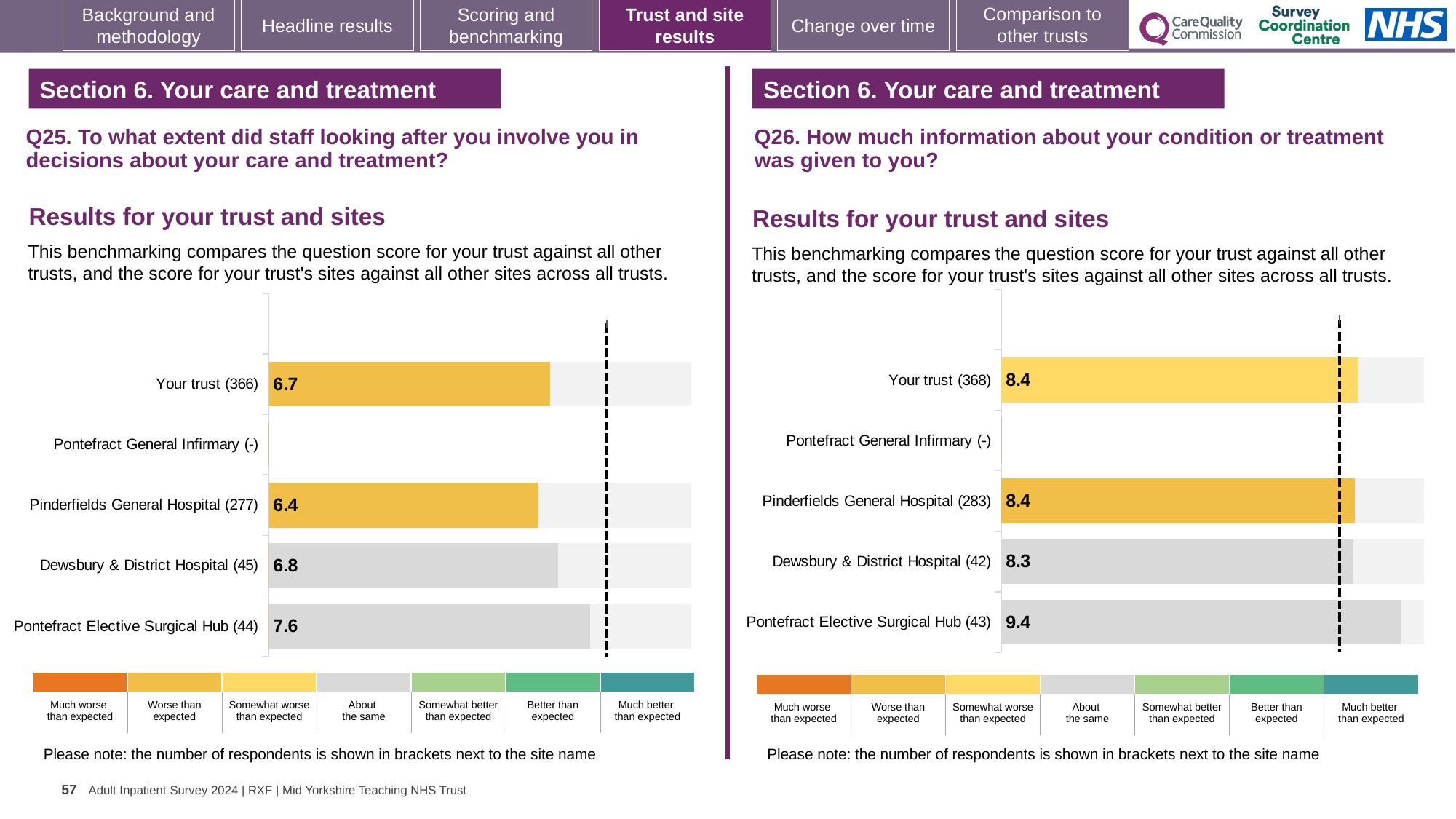
On the Q25 chart (left), what is the score for Pontefract Elective Surgical Hub (44)? 7.6 On the Q26 chart (right), what is the score for Pinderfields General Hospital (283)? 8.4 On the Q25 chart (left), what is the difference between the scores for Pontefract Elective Surgical Hub (44) and Pinderfields General Hospital (277)? 1.2 How many rating categories does the colour legend below the Q25 chart (left) list? 7 On the Q25 chart (left), which has the higher score, Dewsbury & District Hospital (45) or Your trust (366)? Dewsbury & District Hospital (45) On the Q25 chart (left), what is the score for Your trust (366)? 6.7 What kind of chart is used for the Q26 results (right)? Bar chart On the Q26 chart (right), what is the score for Dewsbury & District Hospital (42)? 8.3 On the Q25 chart (left), which site has the lowest score? Pinderfields General Hospital (277) How many trust/site categories are listed on the y axis of the Q25 chart (left)? 5 On the Q26 chart (right), which site has the highest score? Pontefract Elective Surgical Hub (43) On the Q26 chart (right), what is the difference between the scores for Pontefract Elective Surgical Hub (43) and Your trust (368)? 1.0